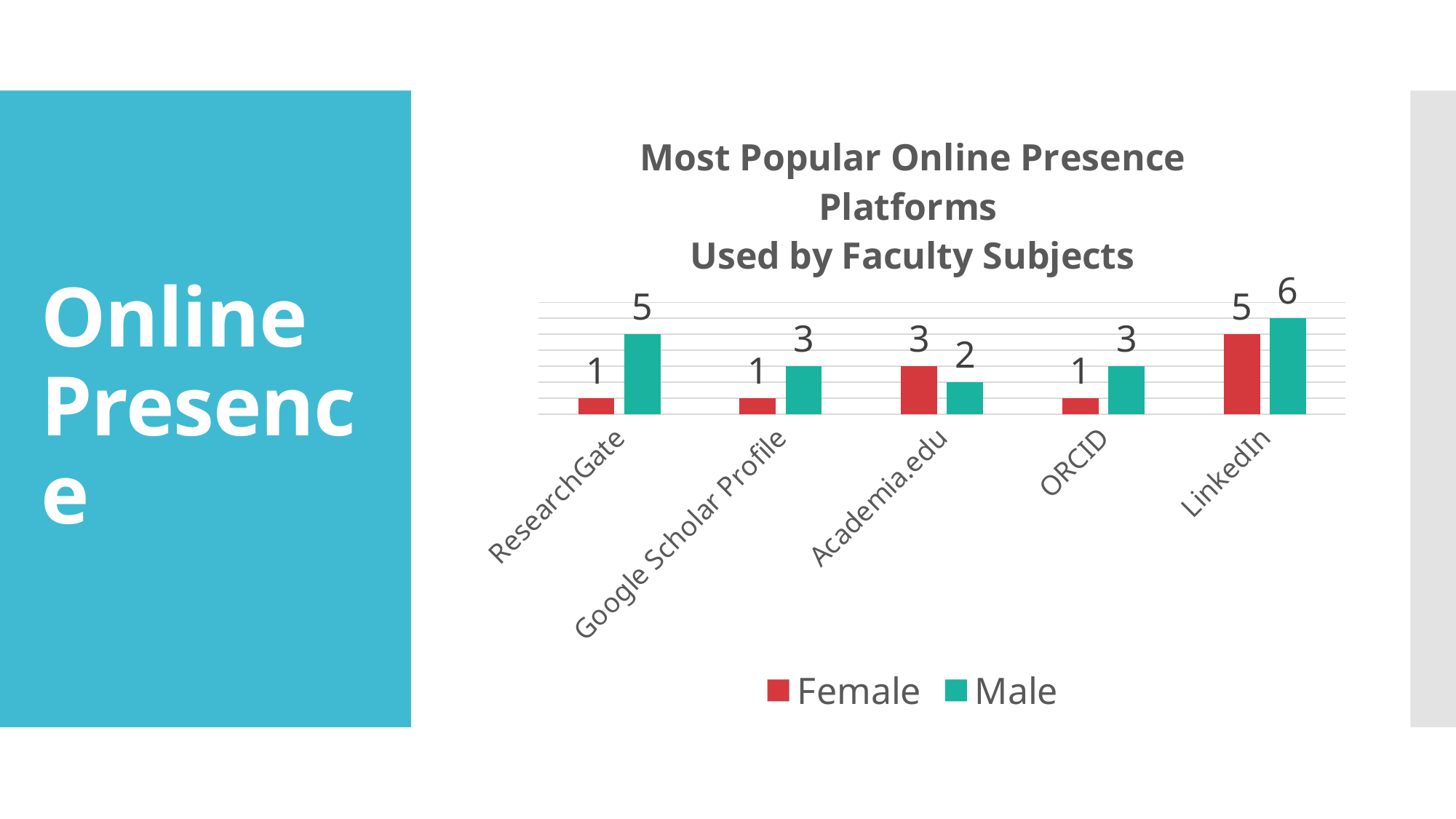
What is the Female value for ORCID? 1 What is the difference between the Male and Female values for ResearchGate? 4 Which platform has the highest Male value? LinkedIn How many series does the legend list? 2 What kind of chart is shown on the slide? Bar chart Which colour represents the Female series in the chart? Red What is the Male value for ResearchGate? 5 Which platform has the lowest Male value? Academia.edu Which is larger for Academia.edu, the Female value or the Male value? Female How many platforms are shown on the x axis? 5 What is the Female value for Academia.edu? 3 What is the Male value for LinkedIn? 6